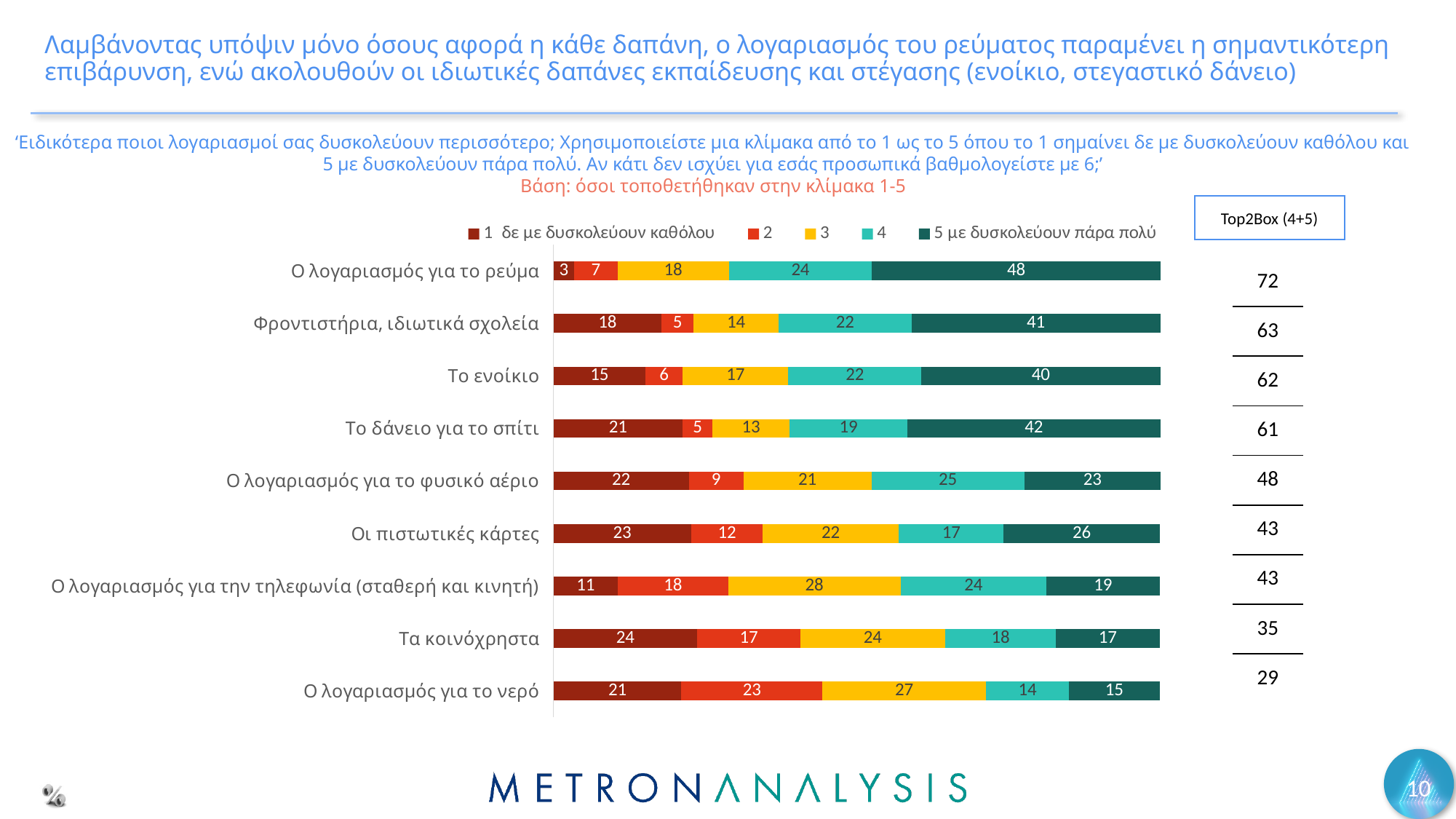
What is the Top2Box (4+5) value shown for 'Το ενοίκιο'? 62 What type of chart is shown on the slide? Stacked bar chart Which category has the lowest value for the '5 με δυσκολεύουν πάρα πολύ' segment? Ο λογαριασμός για το νερό What is the difference between the '5 με δυσκολεύουν πάρα πολύ' values for 'Ο λογαριασμός για το ρεύμα' and 'Ο λογαριασμός για το φυσικό αέριο'? 25 What is the value of the '5 με δυσκολεύουν πάρα πολύ' segment for 'Ο λογαριασμός για το ρεύμα'? 48 What is the value of the '1 δε με δυσκολεύουν καθόλου' segment for 'Τα κοινόχρηστα'? 24 What is the total of the stacked bar for 'Το ενοίκιο'? 100 What is the value of the '4' segment for 'Οι πιστωτικές κάρτες'? 17 How many categories (bars) are shown in the chart? 9 How many series does the legend list? 5 Which category has the highest value for the '5 με δυσκολεύουν πάρα πολύ' segment? Ο λογαριασμός για το ρεύμα Which has the larger '2' segment: 'Ο λογαριασμός για το νερό' or 'Ο λογαριασμός για το ρεύμα'? Ο λογαριασμός για το νερό